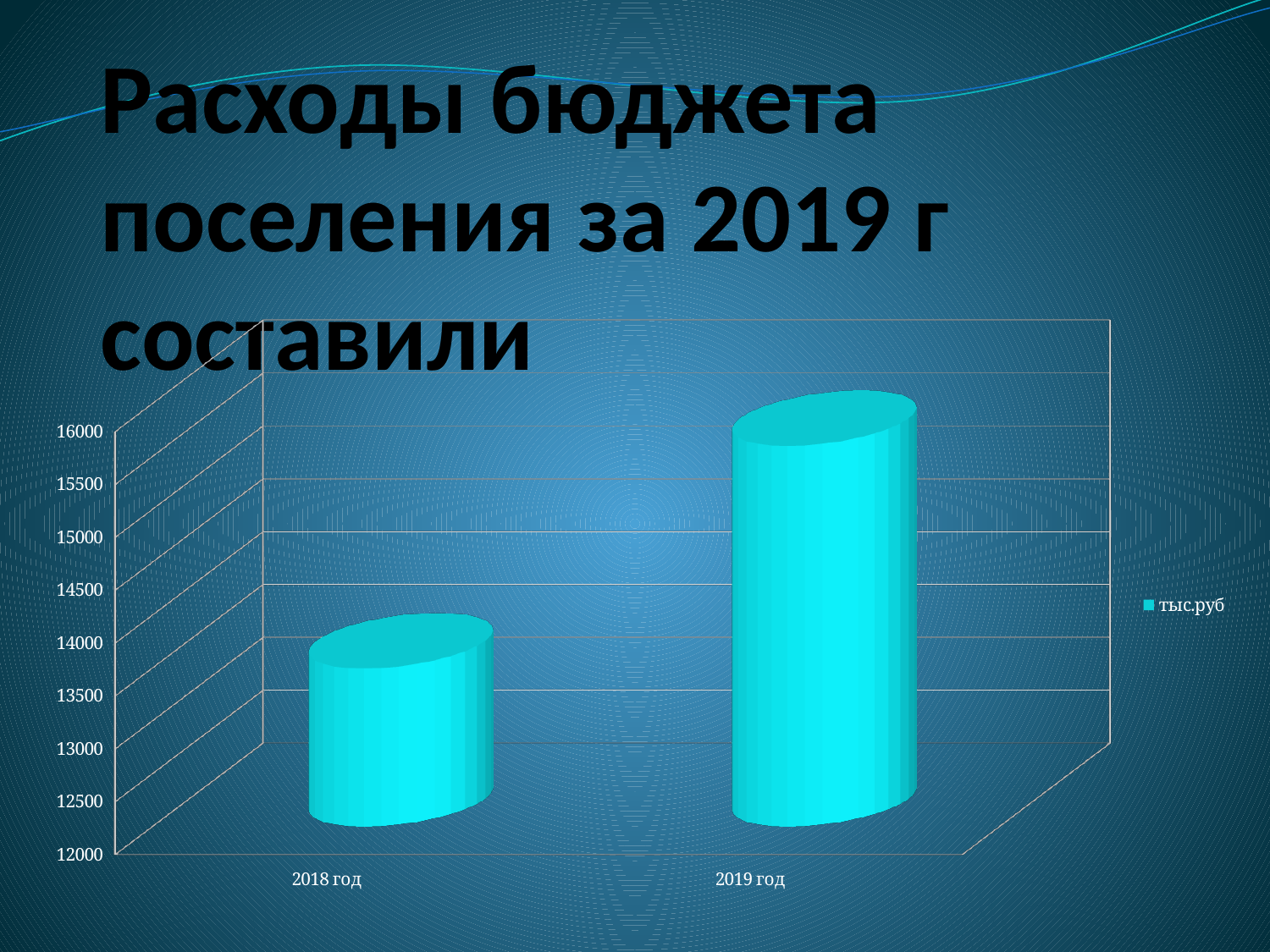
Which category has the lowest value in the chart? 2018 год What is the title of the slide above the chart? Расходы бюджета поселения за 2019 г составили How many categories are shown on the x axis of the chart? 2 What is the legend entry of the series in the chart? тыс.руб Do the values rise or fall from 2018 год to 2019 год? rise Is the value for 2018 год greater or less than 15000? less Which is larger, the value for 2018 год or the value for 2019 год? 2019 год Which category has the highest value in the chart? 2019 год What kind of chart is shown on the slide? bar chart Is the value for 2018 год greater or less than 13000? greater How many series does the chart legend list? 1 Is the value for 2019 год greater or less than 15000? greater